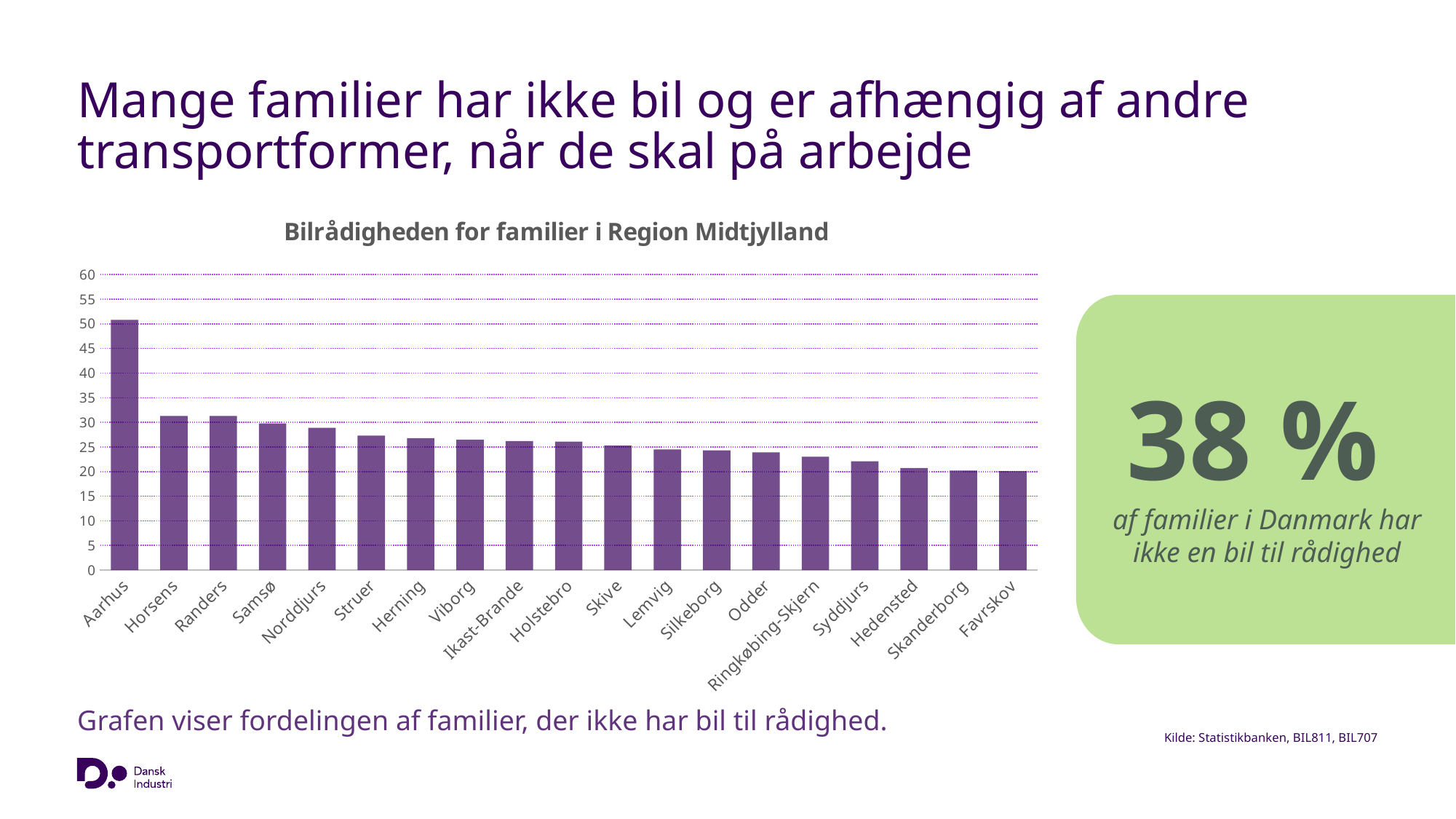
Is the value for Syddjurs greater or less than 25? less Which municipality has the highest value in the chart? Aarhus Is the value for Aarhus greater or less than 45? greater What kind of chart is shown on the slide? Bar chart Is the value for Favrskov greater or less than 25? less Which has a larger value, Aarhus or Horsens? Aarhus What is the title of the chart? Bilrådigheden for familier i Region Midtjylland How many municipalities are shown on the x axis of the chart? 19 Which has a larger value, Samsø or Favrskov? Samsø Do the values generally rise or fall from left to right along the x axis? Fall